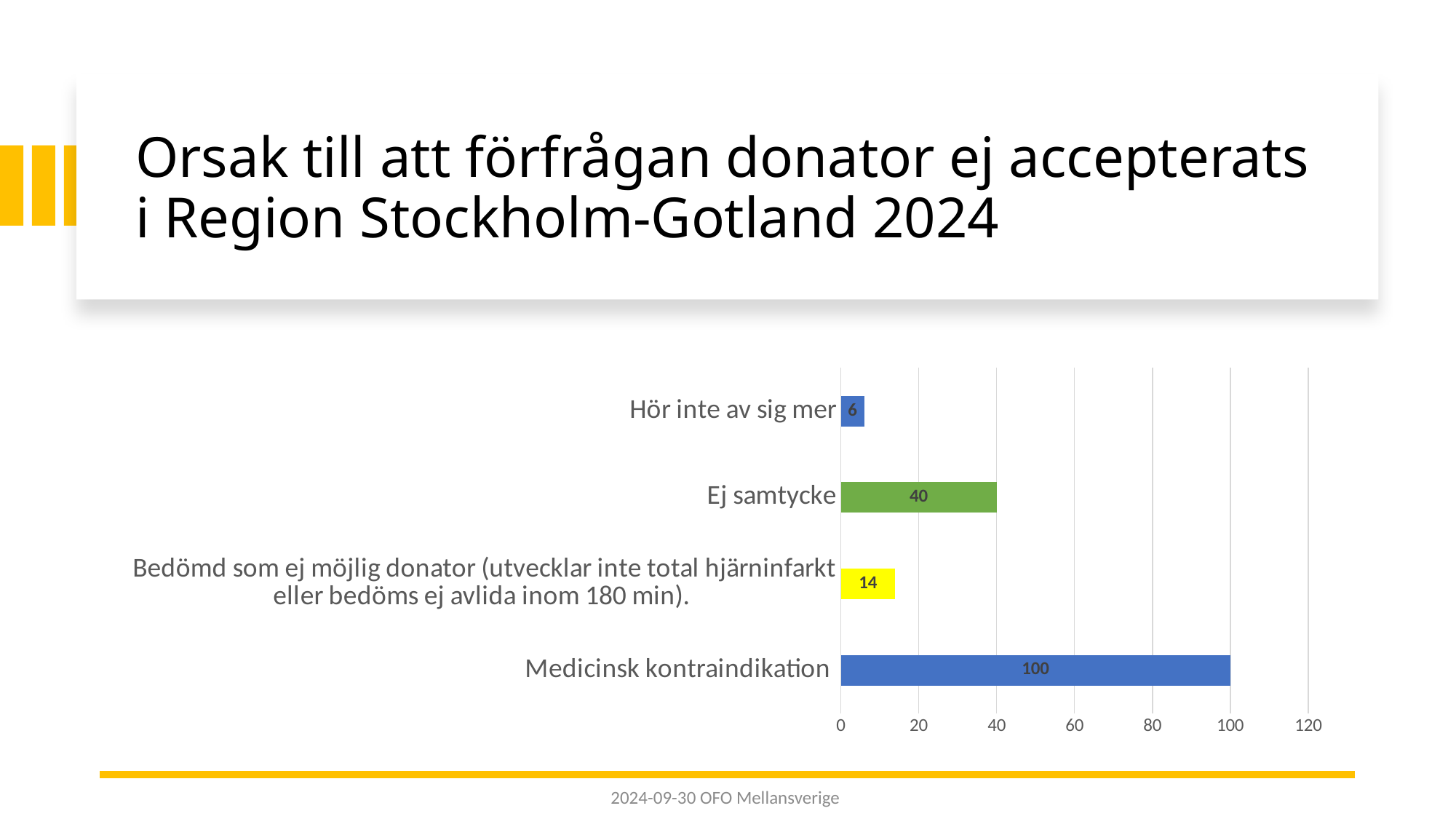
Which category has the highest value? Medicinsk kontraindikation What is the difference between the values for Medicinsk kontraindikation and Ej samtycke? 60 Which is larger, the value for Ej samtycke or the value for Hör inte av sig mer? Ej samtycke What kind of chart is shown on the slide? bar chart What is the value for Hör inte av sig mer? 6 How many categories are shown in the chart? 4 What is the value for the category 'Bedömd som ej möjlig donator (utvecklar inte total hjärninfarkt eller bedöms ej avlida inom 180 min).'? 14 What is the title of the slide containing the chart? Orsak till att förfrågan donator ej accepterats i Region Stockholm-Gotland 2024 Which category has the lowest value? Hör inte av sig mer What is the value for Ej samtycke? 40 Is the value for Ej samtycke greater or less than 60? less What is the value for Medicinsk kontraindikation? 100